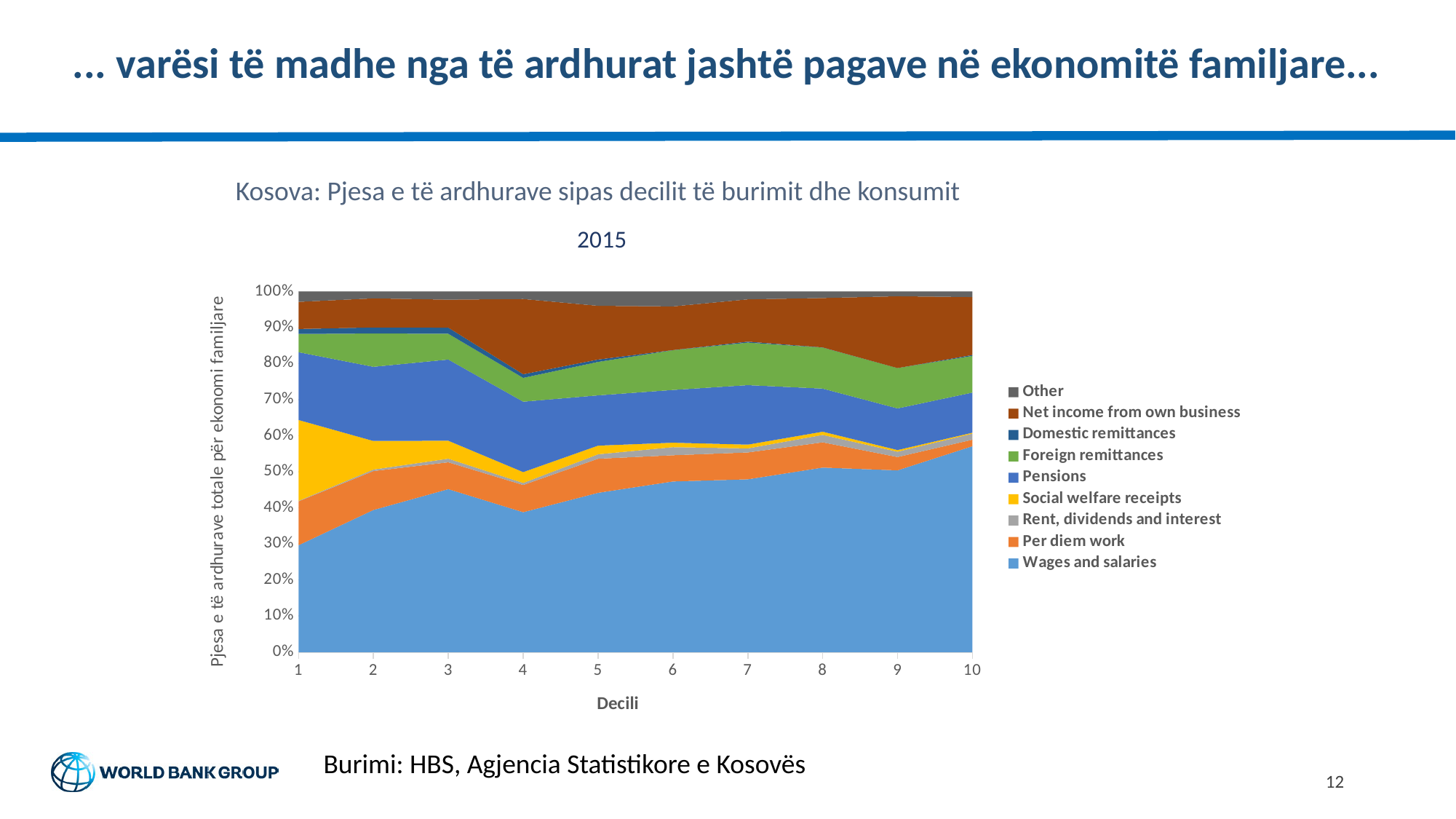
Which series forms the bottom layer of the chart? Wages and salaries In which decile is the share of Social welfare receipts the largest? 1 Is the share of Wages and salaries in decile 10 greater or less than 50%? greater How many series does the legend list? 9 Is the share of Wages and salaries in decile 4 greater or less than 50%? less Is the share of Wages and salaries in decile 1 greater or less than 40%? less Is the share of Wages and salaries larger in decile 1 or in decile 10? decile 10 Does the share of Social welfare receipts generally rise or fall from decile 1 to decile 10? fall Does the share of Wages and salaries generally rise or fall from decile 1 to decile 10? rise What kind of chart is shown on the slide? Stacked area chart What is the title of the chart? Kosova: Pjesa e të ardhurave sipas decilit të burimit dhe konsumit 2015 How many deciles are shown along the x axis? 10